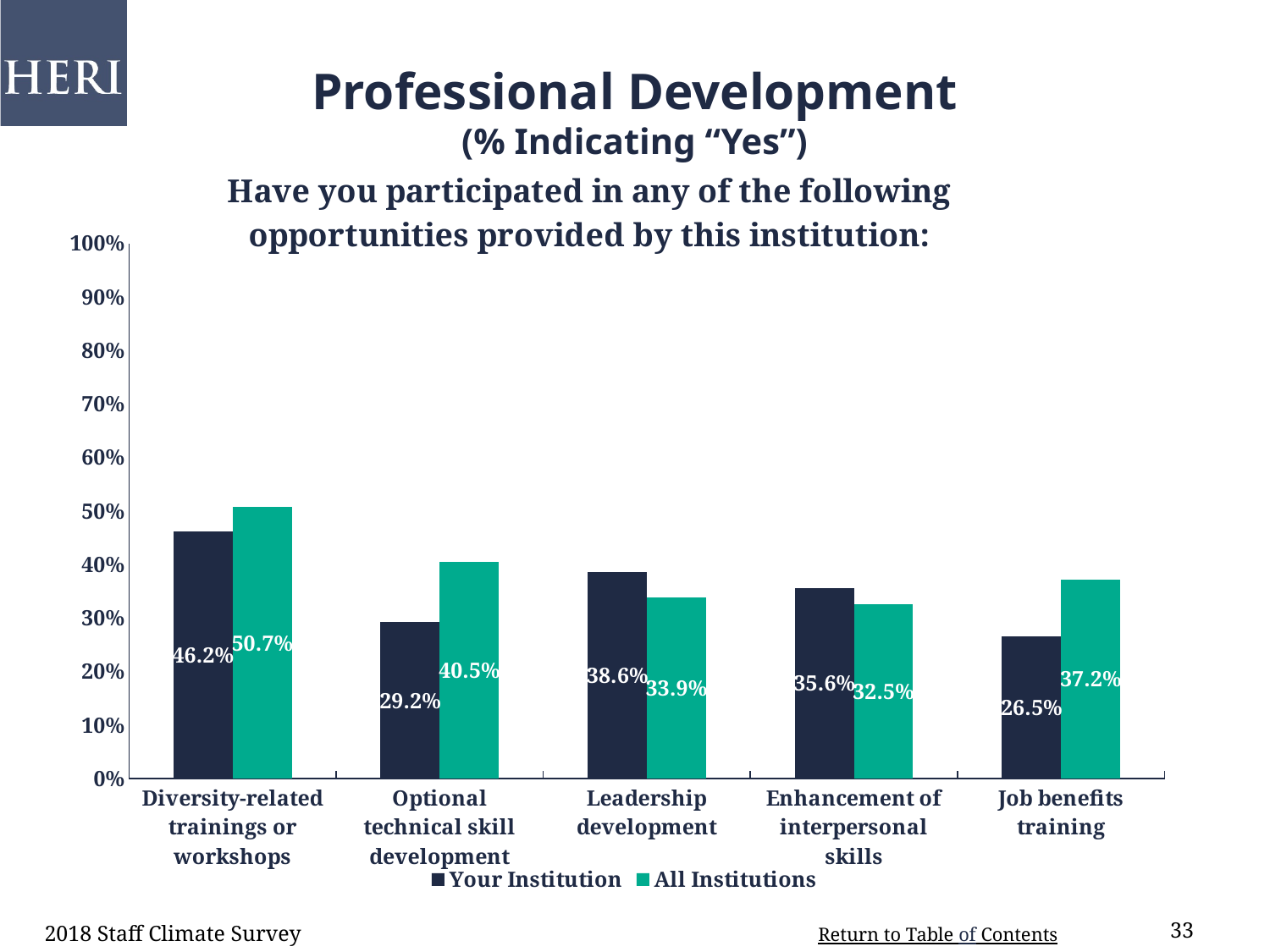
How many categories are shown on the x axis? 5 Which is larger for Enhancement of interpersonal skills: Your Institution or All Institutions? Your Institution Is the value for Your Institution for Optional technical skill development greater or less than 30%? less How many series does the legend list? 2 What are the two series named in the legend? Your Institution and All Institutions Which category has the highest value for All Institutions? Diversity-related trainings or workshops What is the difference between All Institutions and Your Institution for Optional technical skill development? 11.3% What kind of chart is shown on the slide? Bar chart What is the value for All Institutions for Job benefits training? 37.2% What is the value for Your Institution for Leadership development? 38.6% Which category has the lowest value for Your Institution? Job benefits training What is the value for Your Institution for Diversity-related trainings or workshops? 46.2%